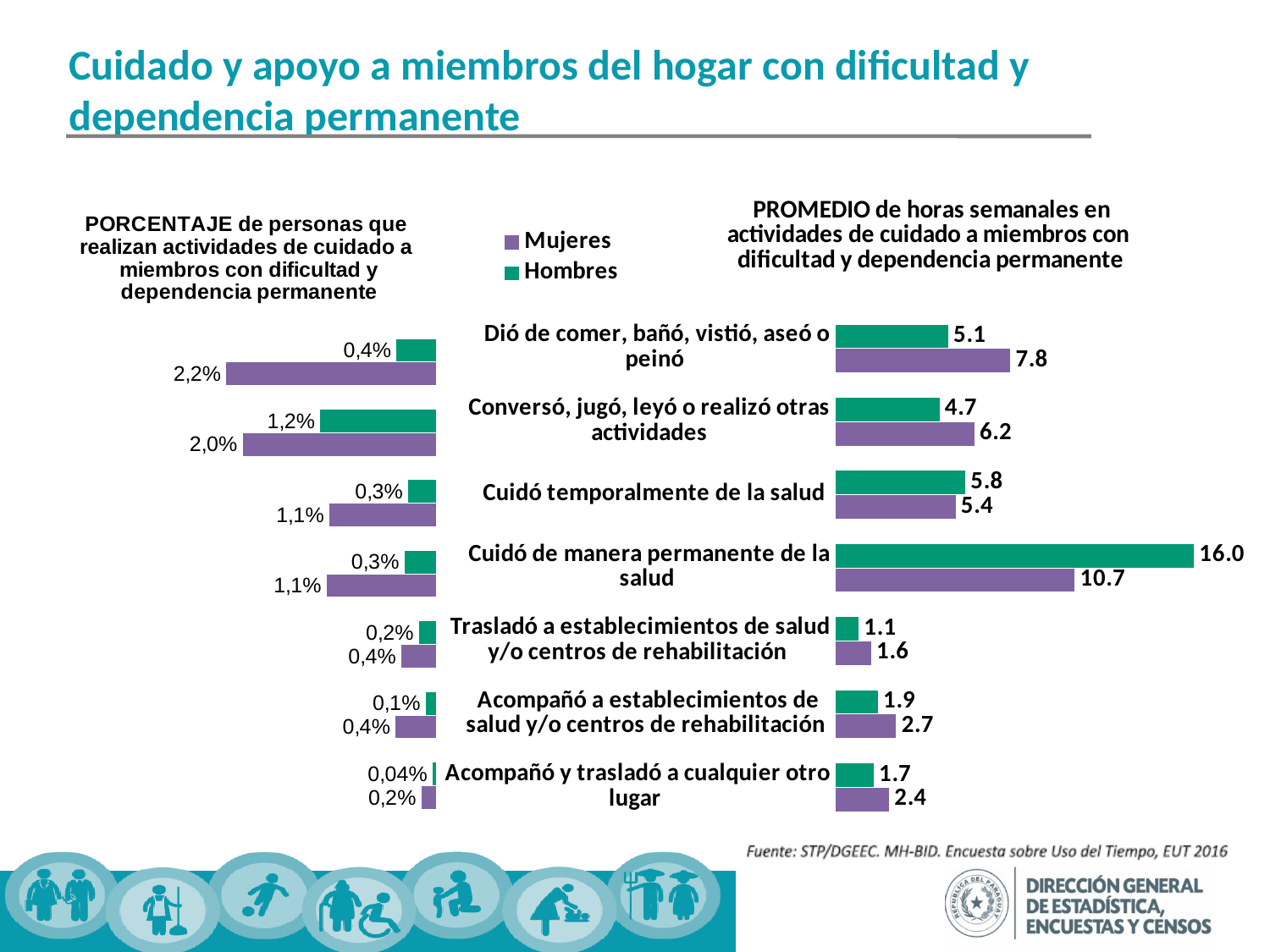
In the PROMEDIO de horas semanales chart, which category has the lowest value for Mujeres? Trasladó a establecimientos de salud y/o centros de rehabilitación In the PORCENTAJE chart on the left, what is the value for Mujeres for 'Conversó, jugó, leyó o realizó otras actividades'? 2,0% In the PROMEDIO de horas semanales chart, which category has the highest value for Hombres? Cuidó de manera permanente de la salud In the PORCENTAJE chart on the left, which is larger for 'Dió de comer, bañó, vistió, aseó o peinó', Mujeres or Hombres? Mujeres In the PROMEDIO de horas semanales chart, what is the value for Hombres for 'Cuidó de manera permanente de la salud'? 16.0 In the PORCENTAJE chart on the left, what is the value for Hombres for 'Acompañó y trasladó a cualquier otro lugar'? 0,04% In the PROMEDIO de horas semanales chart, what is the difference between Hombres and Mujeres for 'Cuidó de manera permanente de la salud'? 5.3 In the PROMEDIO de horas semanales chart, what is the value for Mujeres for 'Dió de comer, bañó, vistió, aseó o peinó'? 7.8 How many categories are shown in the PROMEDIO de horas semanales chart? 7 How many series does the legend list? 2 What type of chart is the PROMEDIO de horas semanales chart? Bar chart In the PROMEDIO de horas semanales chart, which is larger for 'Cuidó temporalmente de la salud', Hombres or Mujeres? Hombres